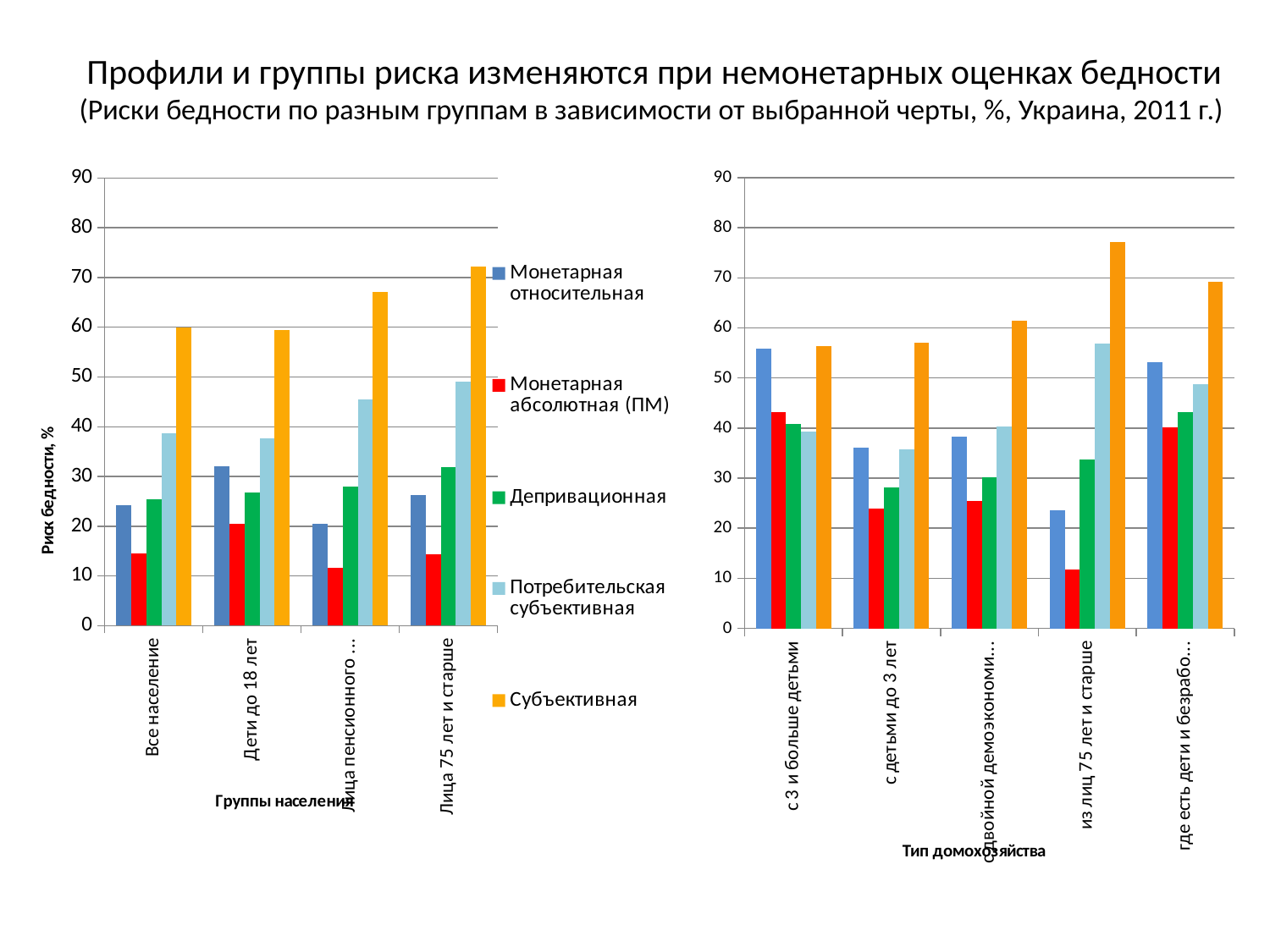
In the right chart (Тип домохозяйства), which household type has the highest Субъективная (orange) value? из лиц 75 лет и старше In the left chart (Группы населения), is the Субъективная value for Все население greater or less than 50? greater How many population groups are shown on the x axis of the left chart (Группы населения)? 4 In the left chart (Группы населения), is the Монетарная абсолютная (ПМ) value for Лица пенсионного возраста greater or less than 20? less In the left chart (Группы населения), which group has the lowest Монетарная абсолютная (ПМ) value? Лица пенсионного возраста What is the title of the vertical axis on the left chart? Риск бедности, % What kind of chart is the left chart (Группы населения)? bar chart How many household types are shown on the x axis of the right chart (Тип домохозяйства)? 5 In the left chart (Группы населения), which group has the highest Субъективная (orange) value? Лица 75 лет и старше How many series does the legend on the left chart list? 5 In the right chart (Тип домохозяйства), which has the larger Монетарная относительная (blue) value: с 3 и больше детьми or с детьми до 3 лет? с 3 и больше детьми In the right chart (Тип домохозяйства), is the Монетарная абсолютная (ПМ) (red) value for households из лиц 75 лет и старше greater or less than 20? less